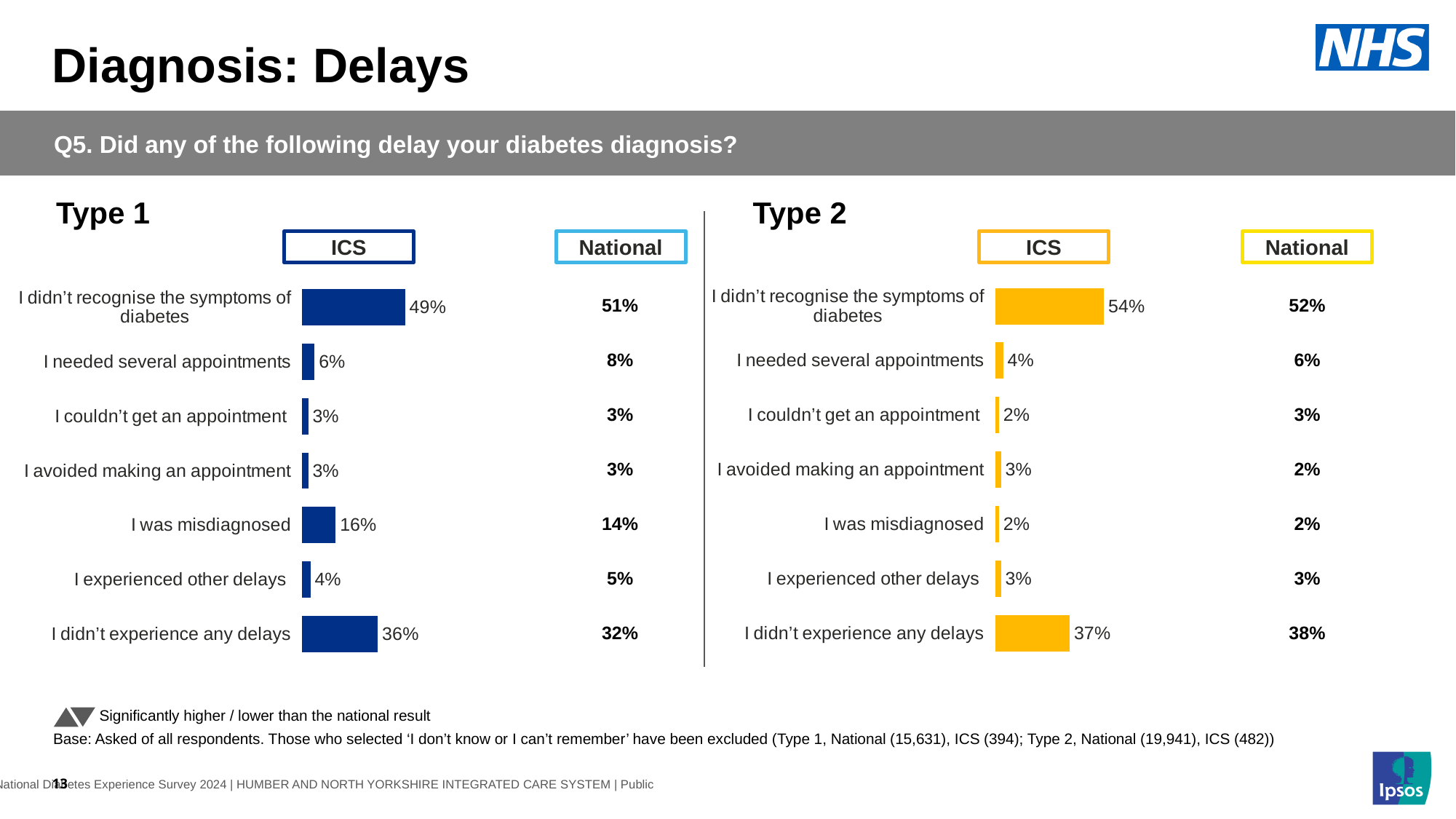
In the Type 2 chart, which category has the highest ICS value? I didn't recognise the symptoms of diabetes In the Type 2 chart, what is the National value for 'I needed several appointments'? 6% In the Type 2 chart, what is the difference between the ICS and National values for 'I didn't recognise the symptoms of diabetes'? 2 percentage points In the Type 1 chart, what is the difference between the ICS and National values for 'I didn't experience any delays'? 4 percentage points In the Type 1 chart, is the ICS value for 'I was misdiagnosed' larger or smaller than the National value? larger In the Type 1 chart, what is the ICS value for 'I didn't recognise the symptoms of diabetes'? 49% How many categories are shown in the Type 1 chart? 7 What kind of chart is used for the ICS values in the Type 1 and Type 2 sections? Bar chart In the Type 2 chart, what is the ICS value for 'I didn't experience any delays'? 37% In the Type 1 chart, which category has the highest ICS value? I didn't recognise the symptoms of diabetes In the Type 2 chart, is the ICS value for 'I needed several appointments' larger or smaller than the National value? smaller In the Type 1 chart, what is the National value for 'I was misdiagnosed'? 14%